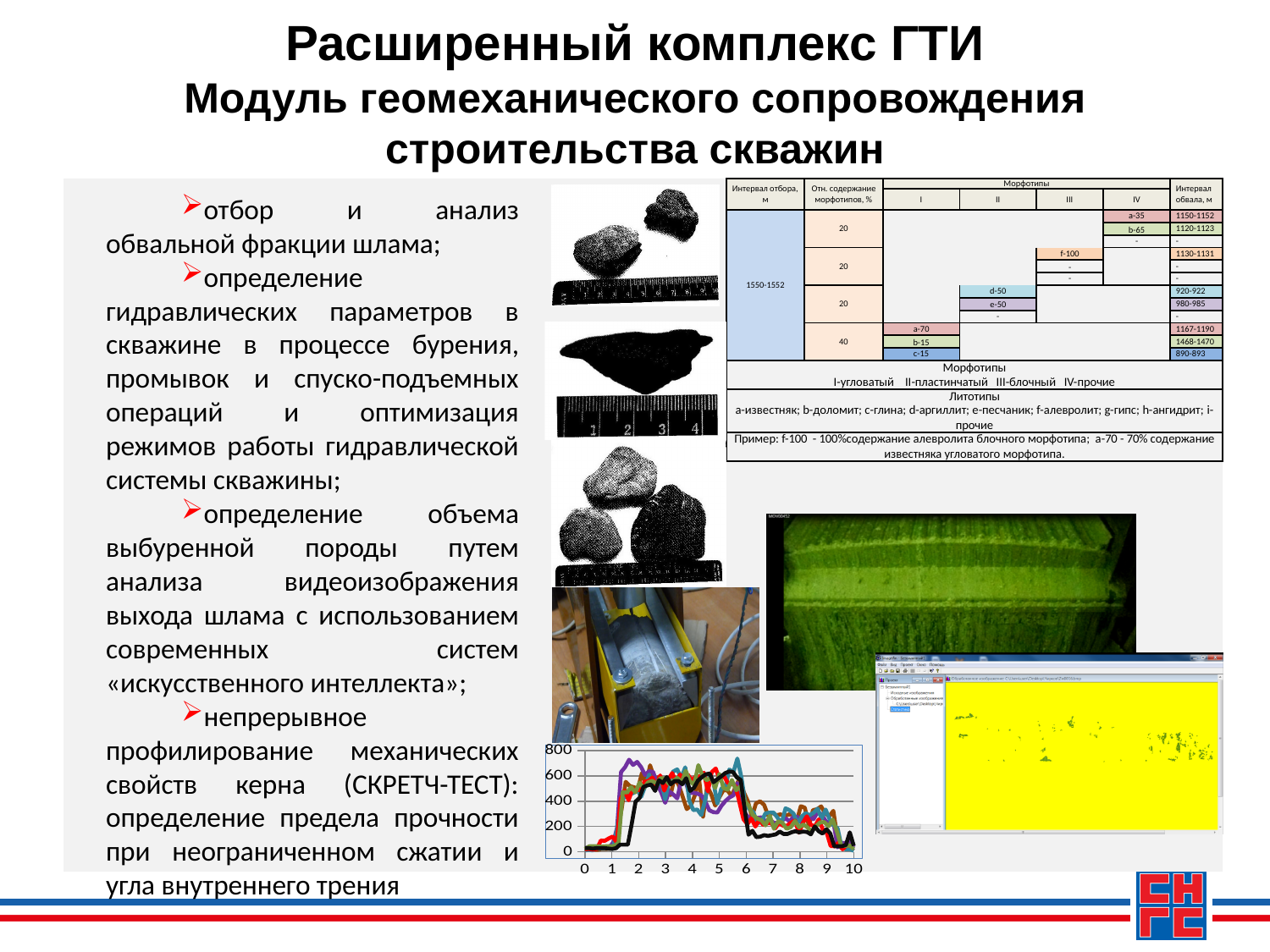
In the line chart, are the values of the lines at x = 9 greater or less than 400? less What kind of chart is shown at the bottom of the slide? line chart In the line chart, do the values rise or fall between x = 6 and x = 7? fall How many labelled tick marks are there on the horizontal axis of the line chart? 11 In the line chart, are the values at x = 0 greater or less than 200? less What is the largest value labelled on the horizontal axis of the line chart? 10 In the line chart, do the values rise or fall between x = 1 and x = 2? rise In the line chart, are the values of the lines at x = 3 greater or less than 400? greater What is the highest value labelled on the vertical axis of the line chart? 800